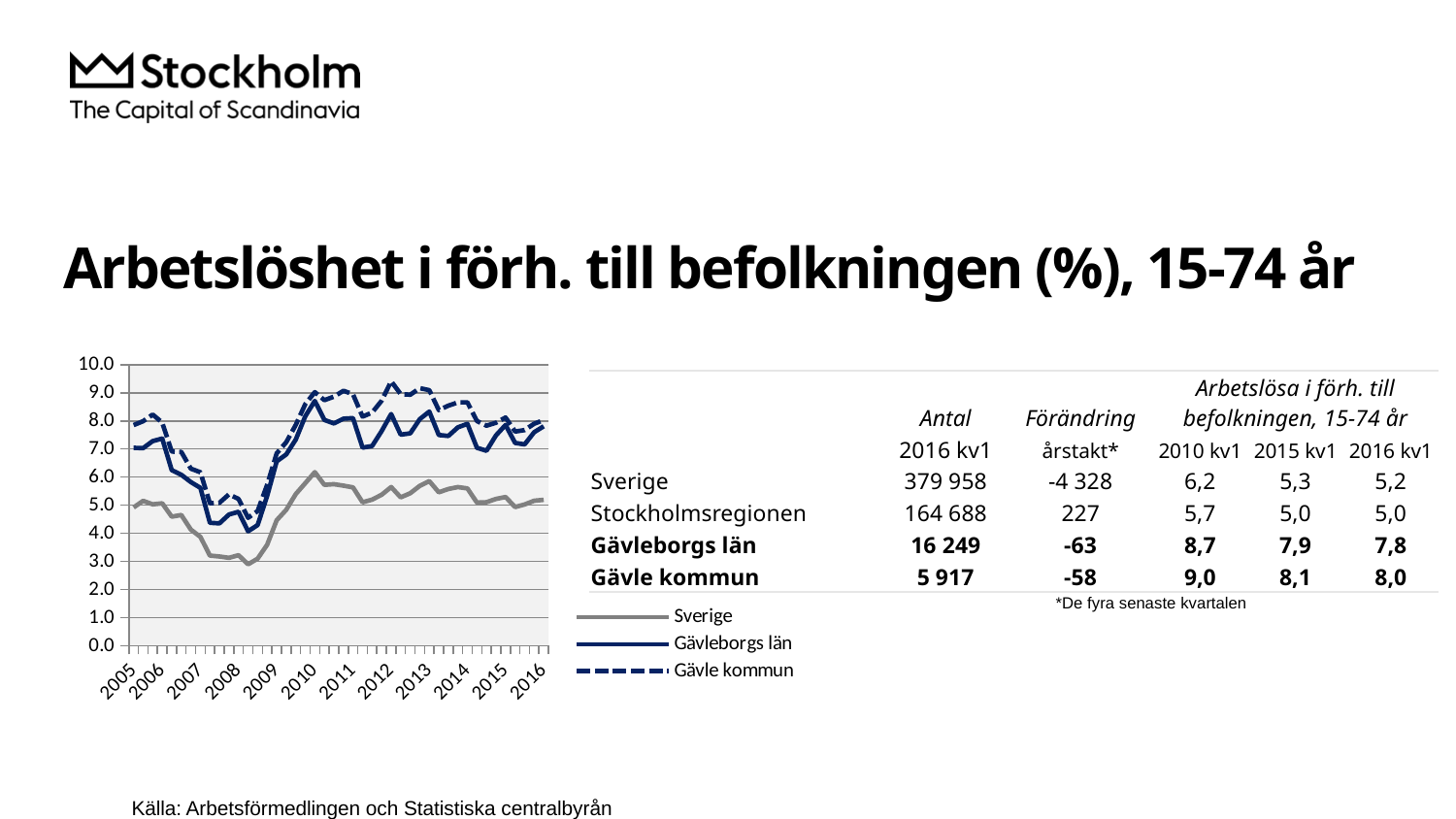
In 2016, which is larger: the value for Sverige or the value for Gävleborgs län? Gävleborgs län Does the Gävleborgs län line rise or fall between 2008 and 2010? rise How many year labels are shown on the chart's x axis? 12 In 2010, which is larger: the value for Gävle kommun or the value for Sverige? Gävle kommun What kind of chart is shown on the slide? line chart Which series are listed in the chart's legend? Sverige, Gävleborgs län, Gävle kommun Does the Sverige line rise or fall between 2005 and 2008? fall How many series does the chart's legend list? 3 Is the value for Sverige in 2008 greater or less than 4.0? less Is the value for Gävleborgs län in 2013 greater or less than 7.0? greater Which series has the lowest value in 2016? Sverige Is the value for Sverige in 2010 greater or less than 5.0? greater